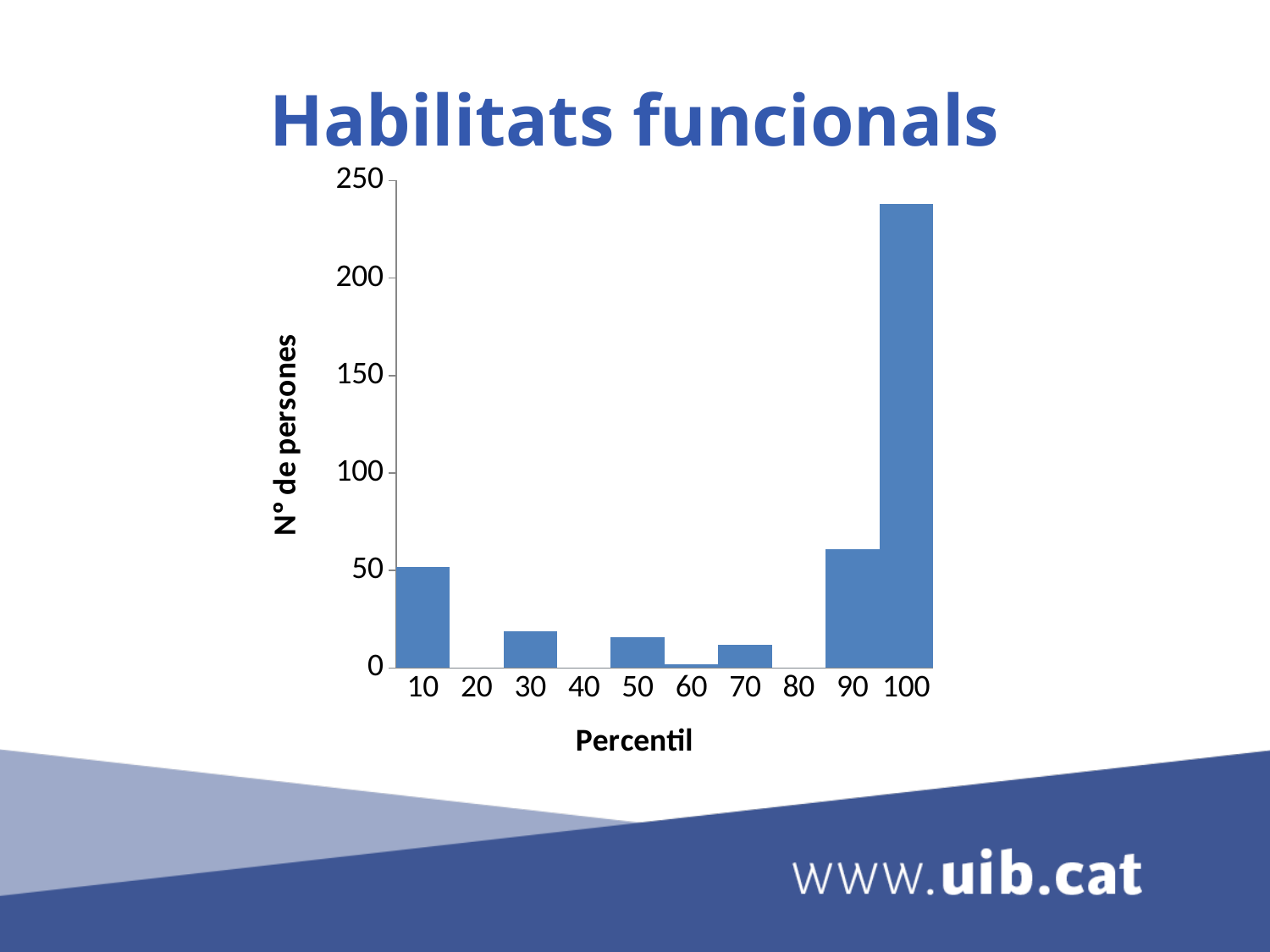
How many percentile categories are shown on the x axis? 10 Is the value for percentile 100 greater or less than 200? greater Which has more persons, percentile 90 or percentile 10? 90 Is the value for percentile 90 greater or less than 100? less Which percentile has the highest number of persons? 100 What is the title of the chart? Habilitats funcionals Is the value for percentile 10 greater or less than 100? less Which has more persons, percentile 100 or percentile 90? 100 What kind of chart is shown on the slide? bar chart Which has more persons, percentile 10 or percentile 30? 10 What is the label of the y axis? Nº de persones